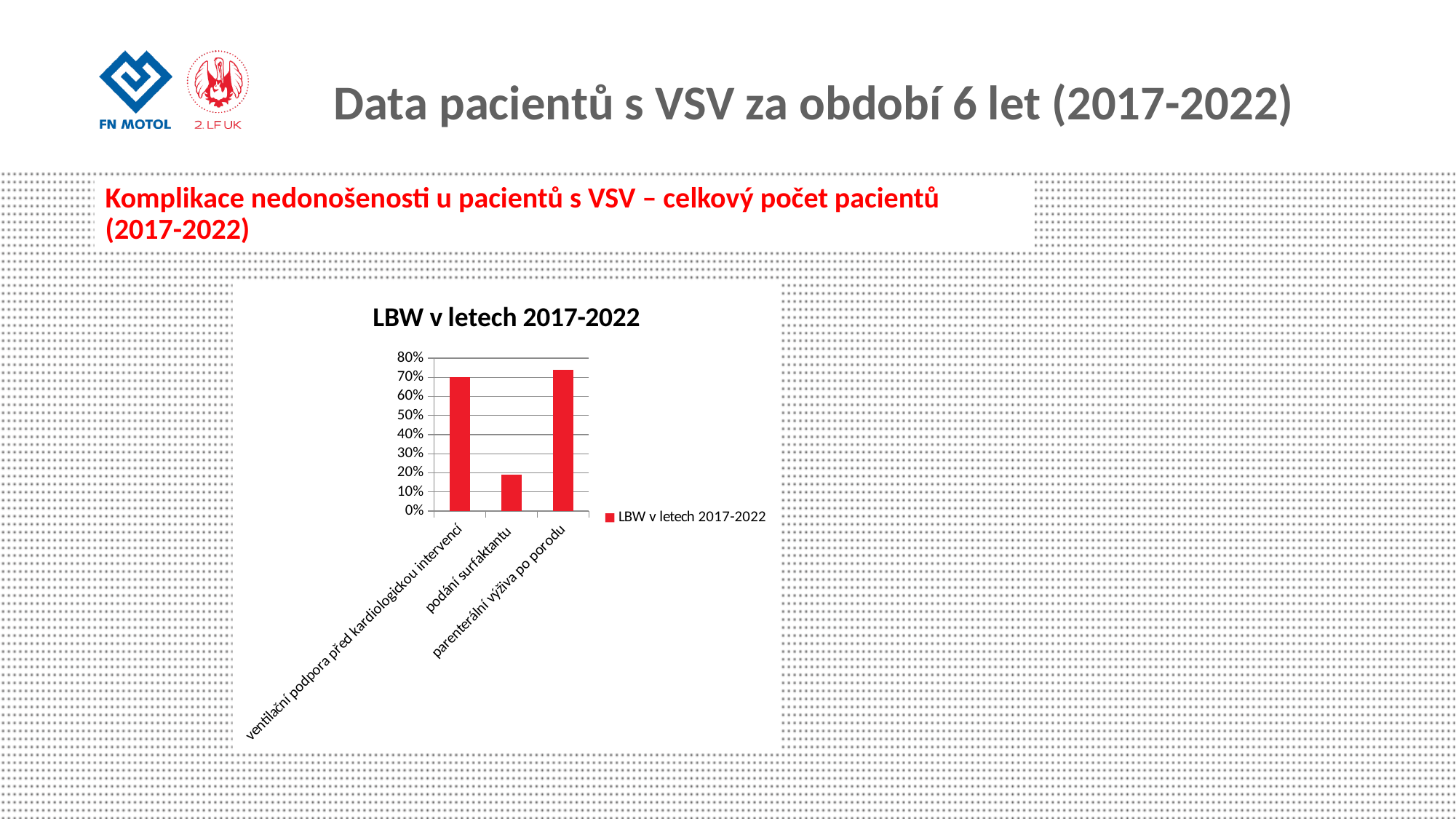
Which is larger: the value for podání surfaktantu or the value for parenterální výživa po porodu? parenterální výživa po porodu What is the title of the chart? LBW v letech 2017-2022 Which category has the lowest value in the chart? podání surfaktantu Is the value for podání surfaktantu greater or less than 10%? greater How many series does the chart legend list? 1 Is the value for podání surfaktantu greater or less than 30%? less What colour are the bars in the chart? red What type of chart is shown on the slide? bar chart Is the value for ventilační podpora před kardiologickou intervencí greater or less than 60%? greater Which category has the highest value in the chart? parenterální výživa po porodu How many categories are shown on the x axis of the chart? 3